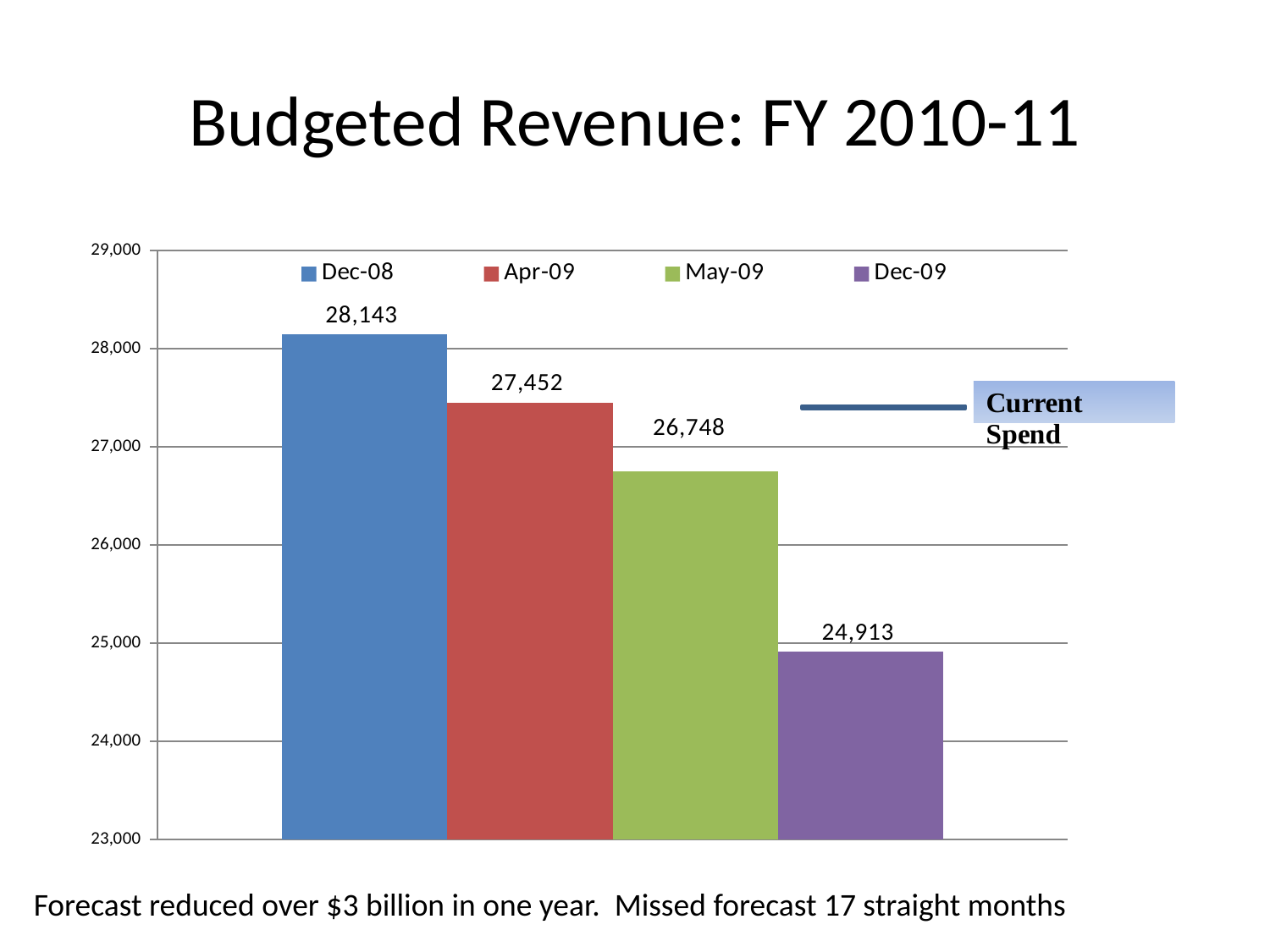
What is the value for Dec-09? 24,913 How many series does the legend list? 4 What is the value for Dec-08? 28,143 Which series has the lowest value? Dec-09 Which is larger, the value for Apr-09 or the value for May-09? Apr-09 Do the values rise or fall from Dec-08 to Dec-09? Fall What kind of chart is shown on the slide? Bar chart What is the difference between the Apr-09 and May-09 values? 704 What is the difference between the Dec-08 and Dec-09 values? 3,230 What is the value for May-09? 26,748 What is the value for Apr-09? 27,452 Which series has the highest value? Dec-08